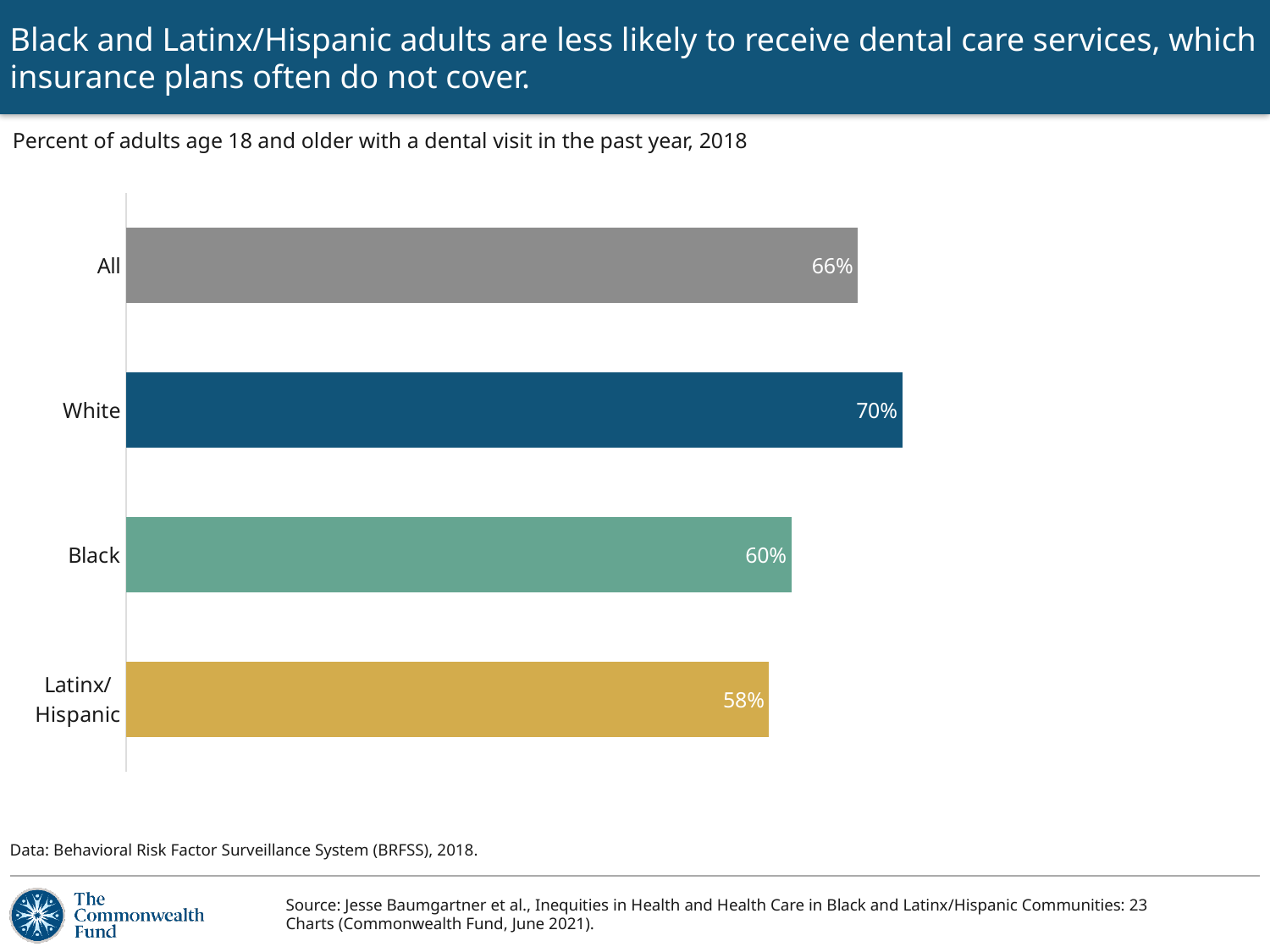
What is the value shown for Black adults? 60% Which group has the highest percent of adults with a dental visit in the past year? White How many groups are shown in the chart? 4 What kind of chart is shown on the slide? Bar chart What is the value shown for White adults? 70% What is the subtitle describing the measure plotted in the chart? Percent of adults age 18 and older with a dental visit in the past year, 2018 What is the difference in percentage points between White adults and Black adults? 10 percentage points Which group has the lowest percent of adults with a dental visit in the past year? Latinx/Hispanic What percent of all adults age 18 and older had a dental visit in the past year? 66% What is the value shown for Latinx/Hispanic adults? 58% What is the difference in percentage points between White adults and Latinx/Hispanic adults? 12 percentage points Which is larger, the value for Black adults or the value for Latinx/Hispanic adults? Black